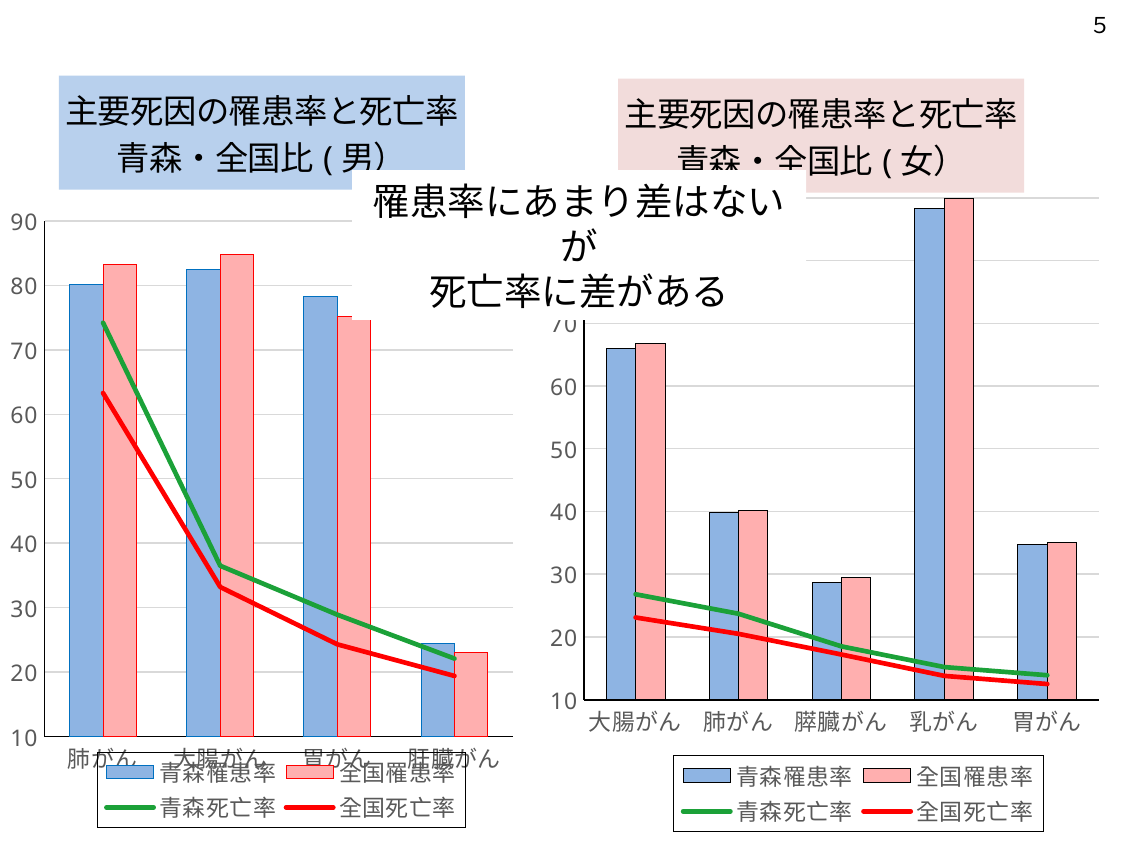
In the left chart (男), which category has the lowest 青森罹患率 bar? 肝臓がん In the left chart (男), is the 青森罹患率 value for 肺がん greater or less than 70? greater In the right chart (女), which category has the highest 青森罹患率 bar? 乳がん In the right chart (女), what colour is the 全国罹患率 series? pink (light red) How many categories are shown on the x axis of the right chart (主要死因の罹患率と死亡率 青森・全国比(女))? 5 How many categories are shown on the x axis of the left chart (主要死因の罹患率と死亡率 青森・全国比(男))? 4 How many series does the legend of the left chart (男) list? 4 In the left chart (男), for 肺がん, which is larger: 青森死亡率 or 全国死亡率? 青森死亡率 What kind of chart is the right chart (女)? bar and line chart In the left chart (男), does the 全国死亡率 line rise or fall from 肺がん to 肝臓がん? fall In the right chart (女), is the 青森死亡率 value for 胃がん greater or less than 20? less In the right chart (女), which category has the lowest 全国罹患率 bar? 膵臓がん